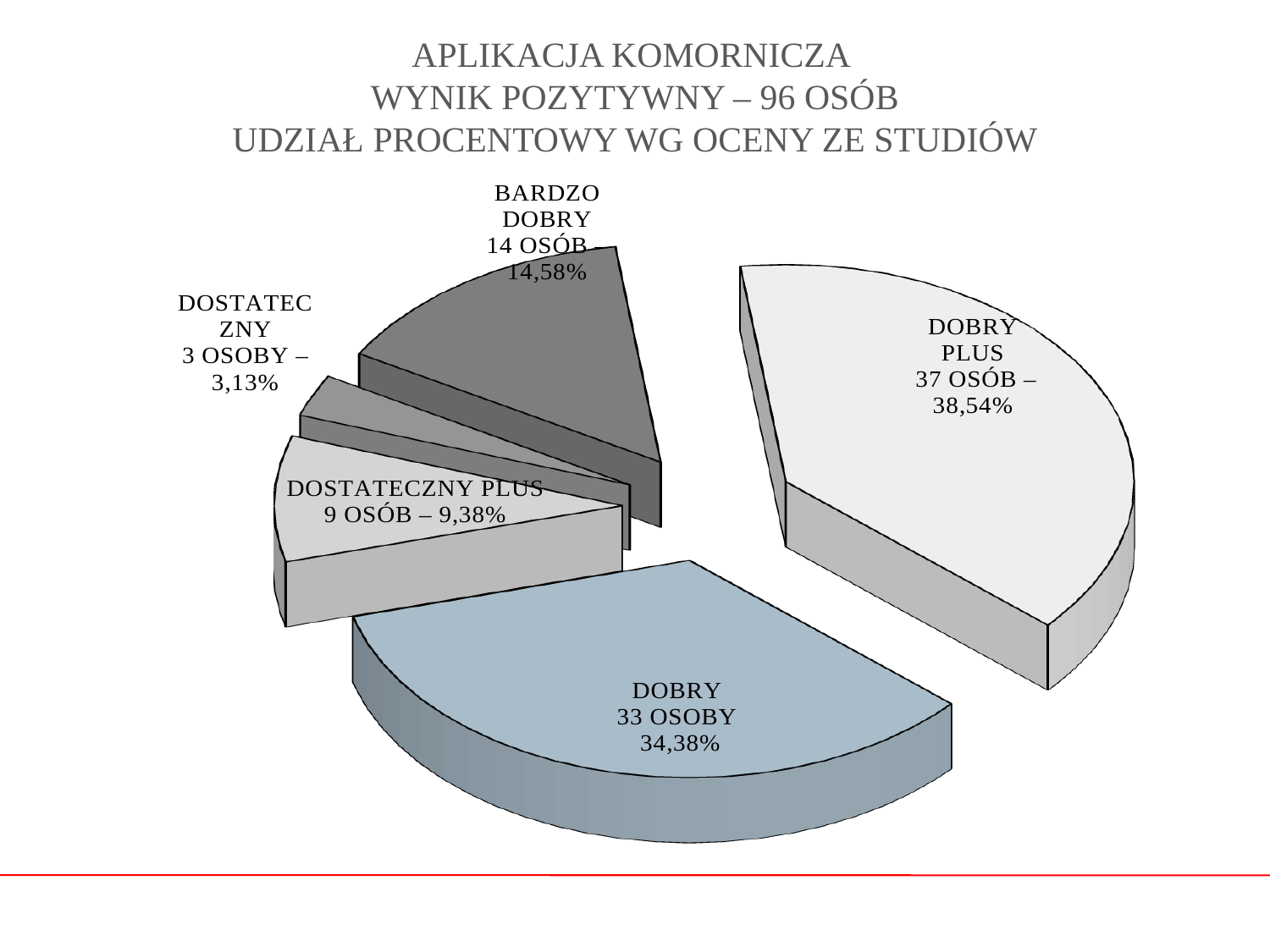
What percentage share does the DOSTATECZNY slice have? 3,13% What kind of chart is shown on the slide? Pie chart How many people are in the DOBRY category? 33 According to the chart title, how many people in total achieved a positive result? 96 Which category has more people, BARDZO DOBRY or DOSTATECZNY PLUS? BARDZO DOBRY Which category has the largest share of the pie? DOBRY PLUS What is the difference in number of people between DOBRY PLUS and DOBRY? 4 How many slices does the pie chart have? 5 How many people are in the DOSTATECZNY PLUS category? 9 Which category has the smallest share of the pie? DOSTATECZNY What percentage share does the BARDZO DOBRY slice have? 14,58% What percentage share does the DOBRY PLUS slice have? 38,54%